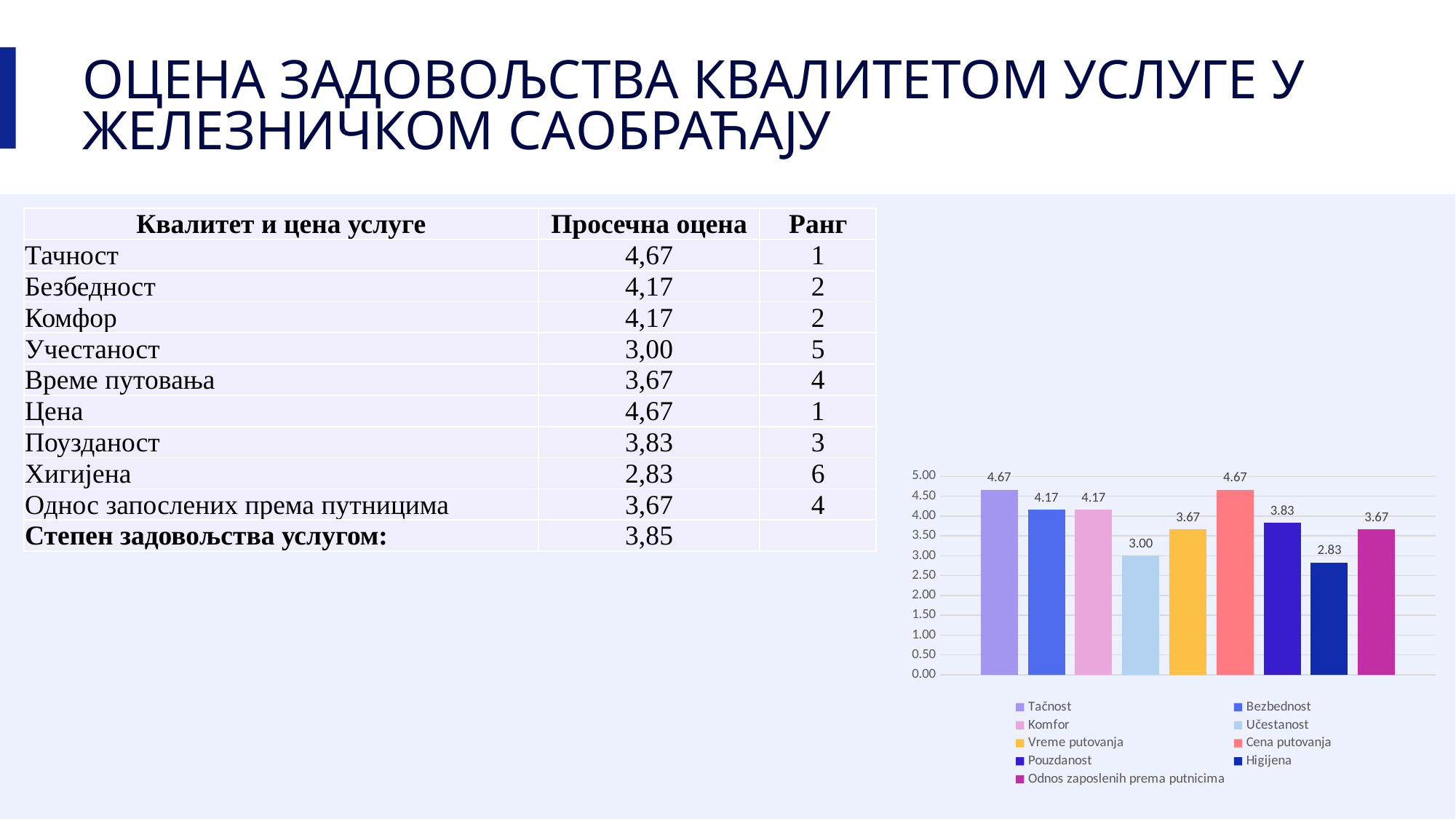
Is the value for Odnos zaposlenih prema putnicima greater or less than 4.00? less What is the value shown for Tačnost in the chart? 4.67 What colour is the bar for Cena putovanja in the chart? coral red What type of chart is shown on the slide? bar chart Which category has the lowest value in the chart? Higijena What is the difference between the values for Cena putovanja and Higijena? 1.84 What is the value shown for Učestanost in the chart? 3.00 How many entries does the chart legend list? 9 How many bars are plotted in the chart? 9 What is the value shown for Pouzdanost in the chart? 3.83 Which is larger, the value for Bezbednost or the value for Vreme putovanja? Bezbednost What is the value shown for Higijena in the chart? 2.83